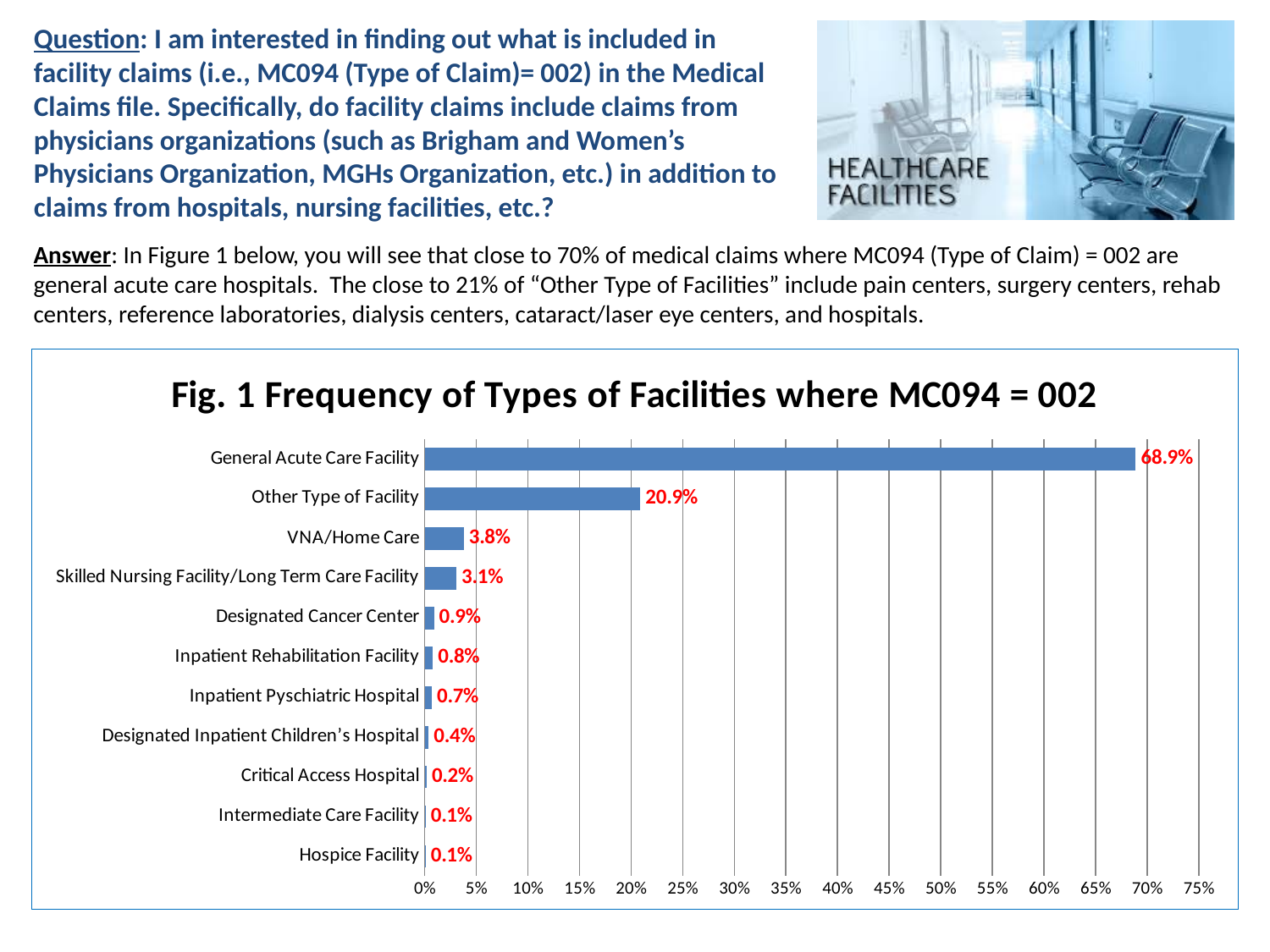
What kind of chart is this? bar chart What is the value for General Acute Care Facility? 68.9% What is the value for Skilled Nursing Facility/Long Term Care Facility? 3.1% What is the difference between General Acute Care Facility and Other Type of Facility? 48.0% What is the title of the chart? Fig. 1 Frequency of Types of Facilities where MC094 = 002 Is the value for General Acute Care Facility greater or less than 65%? greater Which category has the highest value? General Acute Care Facility How many categories are shown in the chart? 11 What is the value for VNA/Home Care? 3.8% What is the value for Designated Cancer Center? 0.9% Which is larger, VNA/Home Care or Skilled Nursing Facility/Long Term Care Facility? VNA/Home Care What is the value for Other Type of Facility? 20.9%